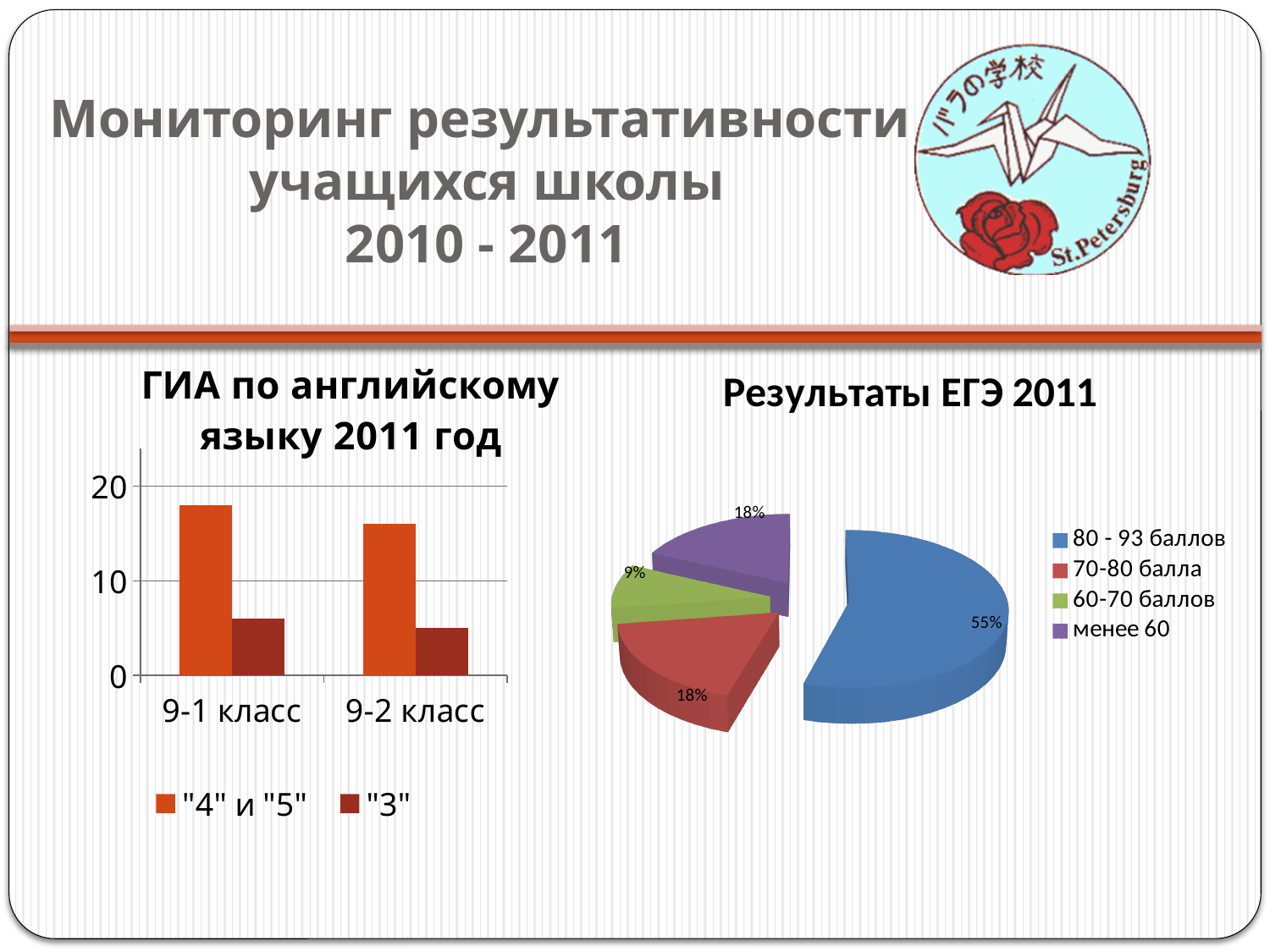
How many series does the legend of the chart 'ГИА по английскому языку 2011 год' list? 2 How many categories does the legend of the chart 'Результаты ЕГЭ 2011' list? 4 What kind of chart is 'Результаты ЕГЭ 2011'? pie chart In the chart 'Результаты ЕГЭ 2011', what share of the pie is 'менее 60'? 18% In the chart 'Результаты ЕГЭ 2011', which category has the smallest slice? 60-70 баллов In the chart 'ГИА по английскому языку 2011 год', is the value for '"4" и "5"' in '9-1 класс' greater or less than 10? greater In the chart 'Результаты ЕГЭ 2011', what is the difference in percentage points between '80 - 93 баллов' and '70-80 балла'? 37 What kind of chart is 'ГИА по английскому языку 2011 год'? bar chart In the chart 'Результаты ЕГЭ 2011', what share of the pie is '80 - 93 баллов'? 55% In the chart 'Результаты ЕГЭ 2011', which category has the largest slice? 80 - 93 баллов In the chart 'ГИА по английскому языку 2011 год', which is larger for '9-2 класс': '"4" и "5"' or '"3"'? "4" и "5" In the chart 'Результаты ЕГЭ 2011', what share of the pie is '60-70 баллов'? 9%